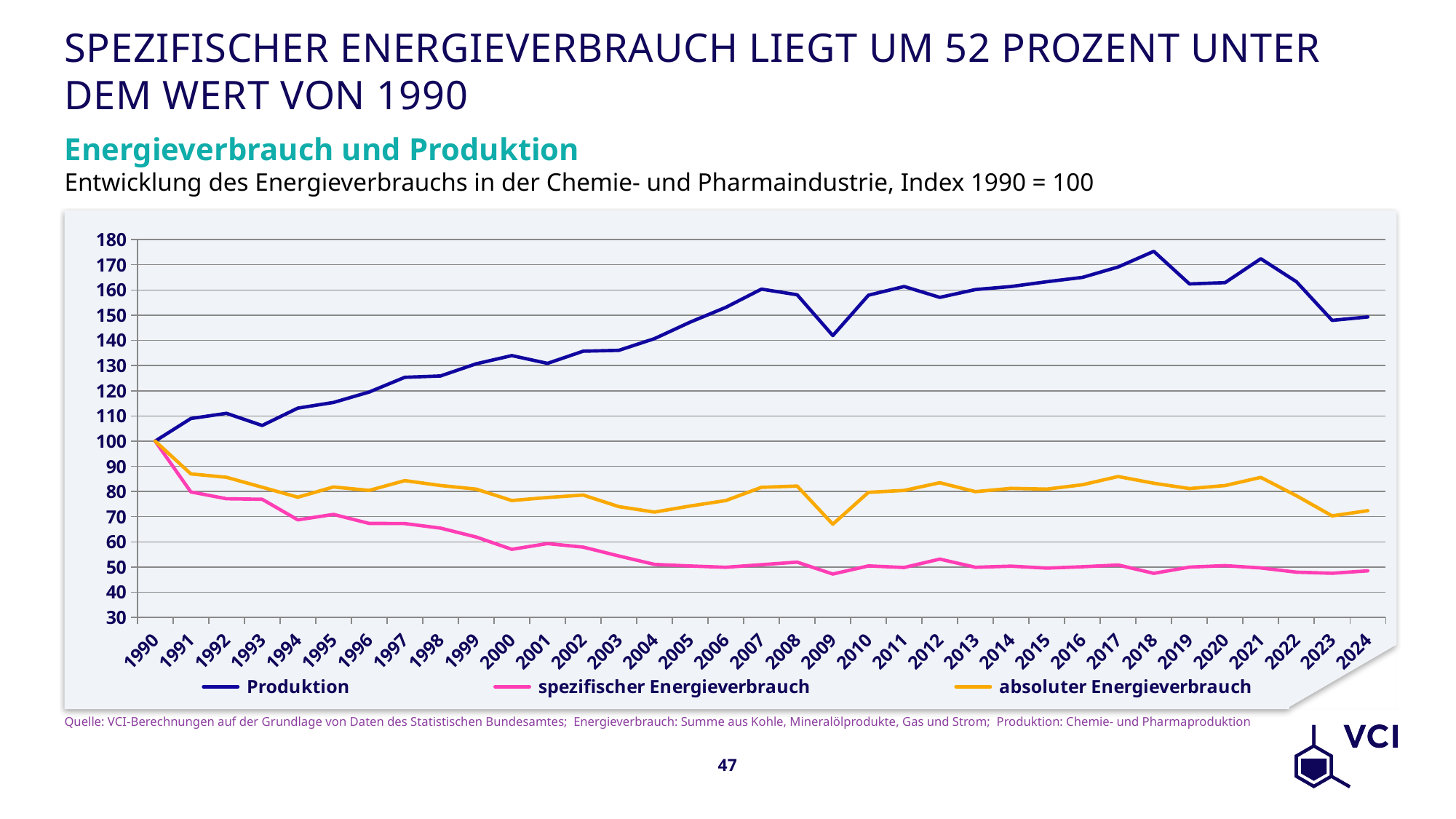
Does the spezifischer Energieverbrauch series generally rise or fall from 1990 to 2024? fall How many years are plotted along the x axis? 35 How many series does the legend list? 3 What is the index value of Produktion in 1990? 100 Is the value for Produktion in 2018 greater or less than 170? greater In 2024, which is larger: Produktion or spezifischer Energieverbrauch? Produktion In which year does the Produktion series reach its highest value? 2018 What kind of chart is shown on the slide? line chart Is the value for absoluter Energieverbrauch in 2009 greater or less than 70? less In which year is the Produktion series at its lowest value? 1990 Is the value for Produktion in 2009 greater or less than 150? less